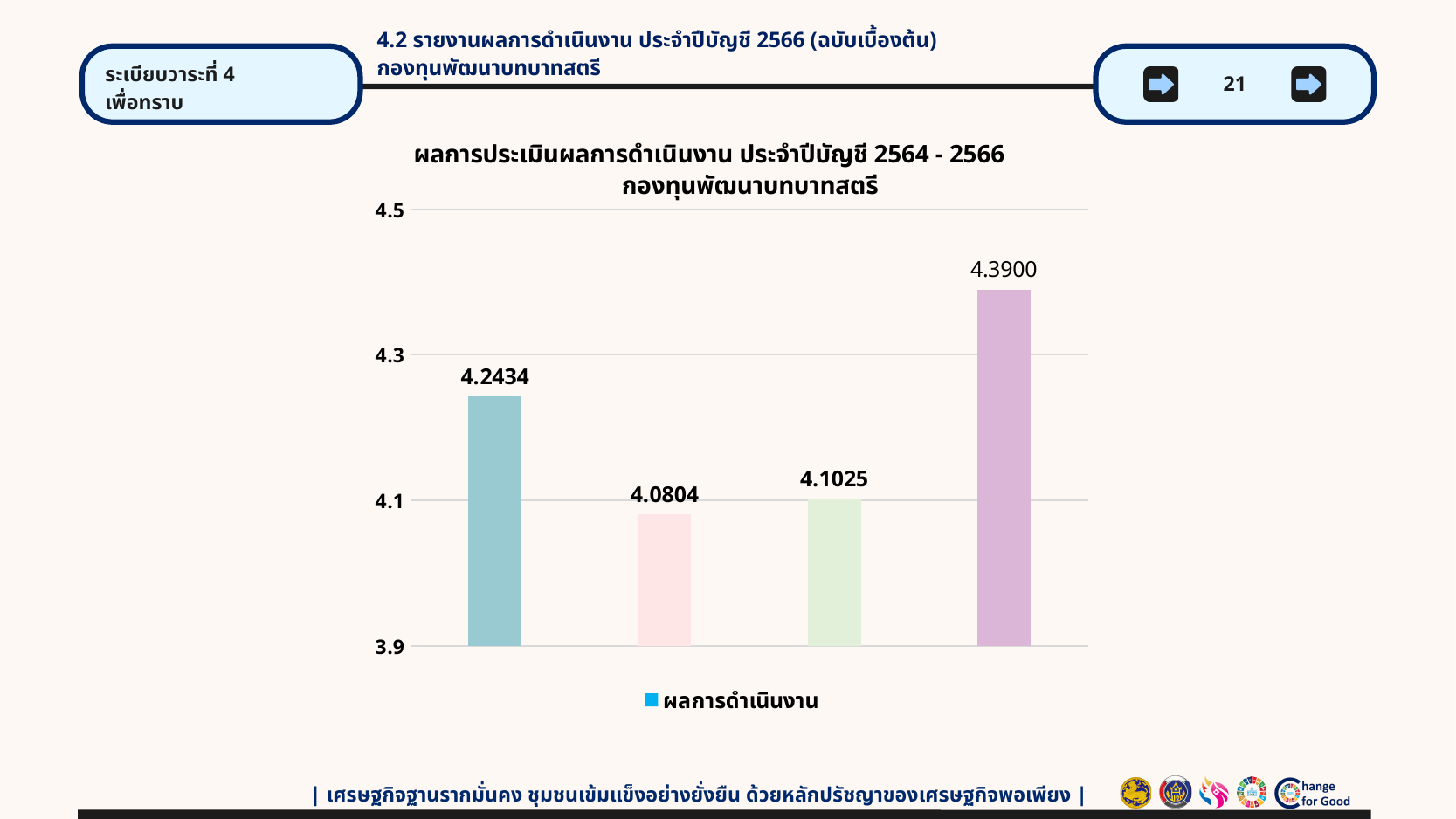
What is the legend entry shown below the chart? ผลการดำเนินงาน Which is larger, the second bar or the third bar? the third bar (4.1025) What is the value shown on the third bar from the left? 4.1025 What is the difference between the rightmost bar (4.3900) and the leftmost bar (4.2434)? 0.1466 How many bars are plotted in the chart? 4 What is the value shown on the fourth (rightmost) bar? 4.3900 Which bar has the lowest value? the second bar, 4.0804 What is the value shown on the second bar from the left? 4.0804 What kind of chart is shown on the slide? bar chart Which bar has the highest value? the fourth (rightmost) bar, 4.3900 How many series does the legend list? 1 What is the value shown on the first (leftmost) bar? 4.2434